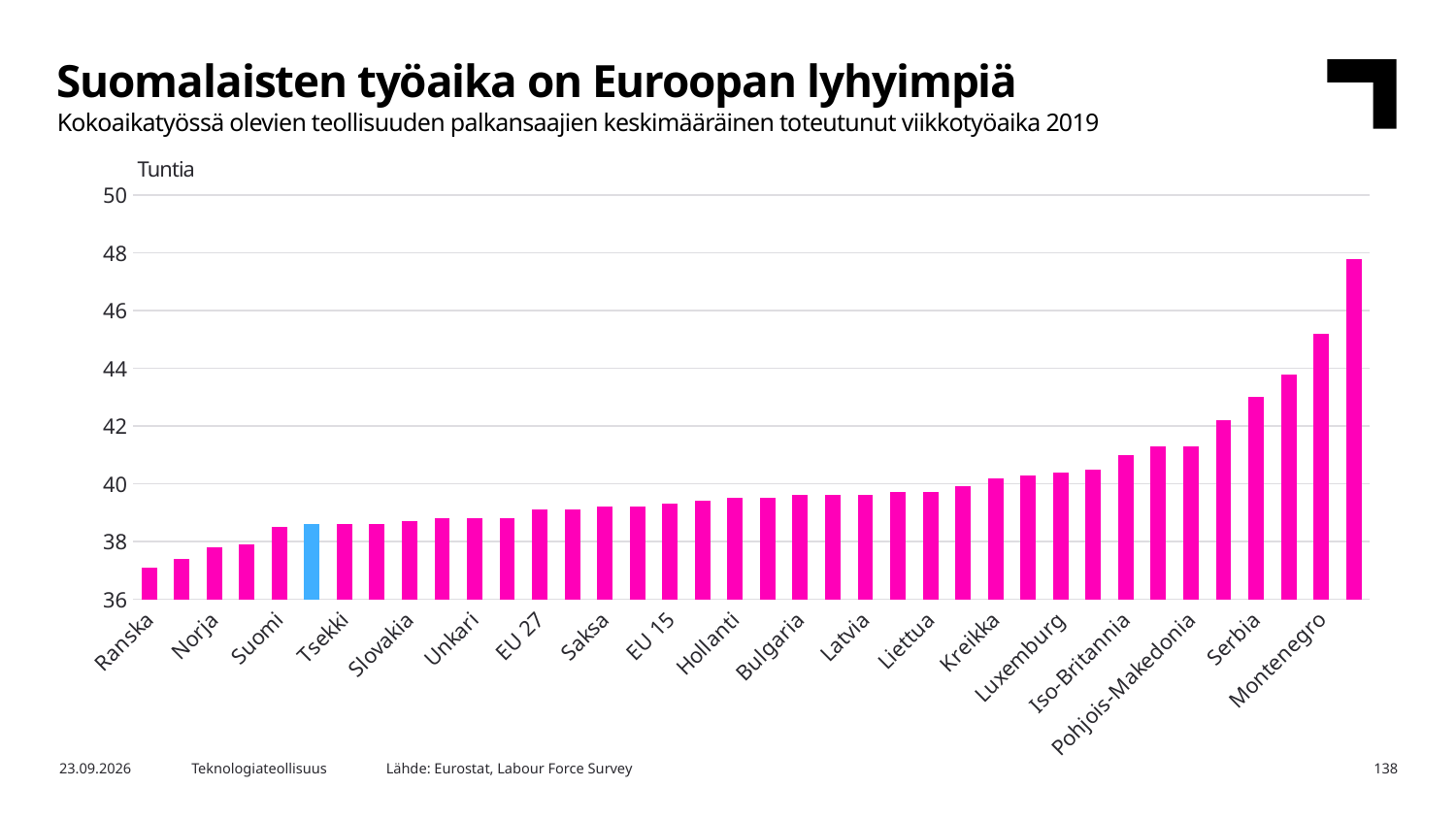
What kind of chart is shown on the slide? bar chart Which country has the lowest average weekly working time in the chart? Ranska Do the bar values rise or fall from left to right along the x axis? rise Which is larger, the value for Saksa or the value for Suomi? Saksa Which is larger, the value for Montenegro or the value for Serbia? Montenegro Is the value for Saksa greater or less than 40? less Is the value for Montenegro greater or less than 46? less Is the value for Serbia greater or less than 42? greater What unit is shown on the vertical axis of the chart? Tuntia